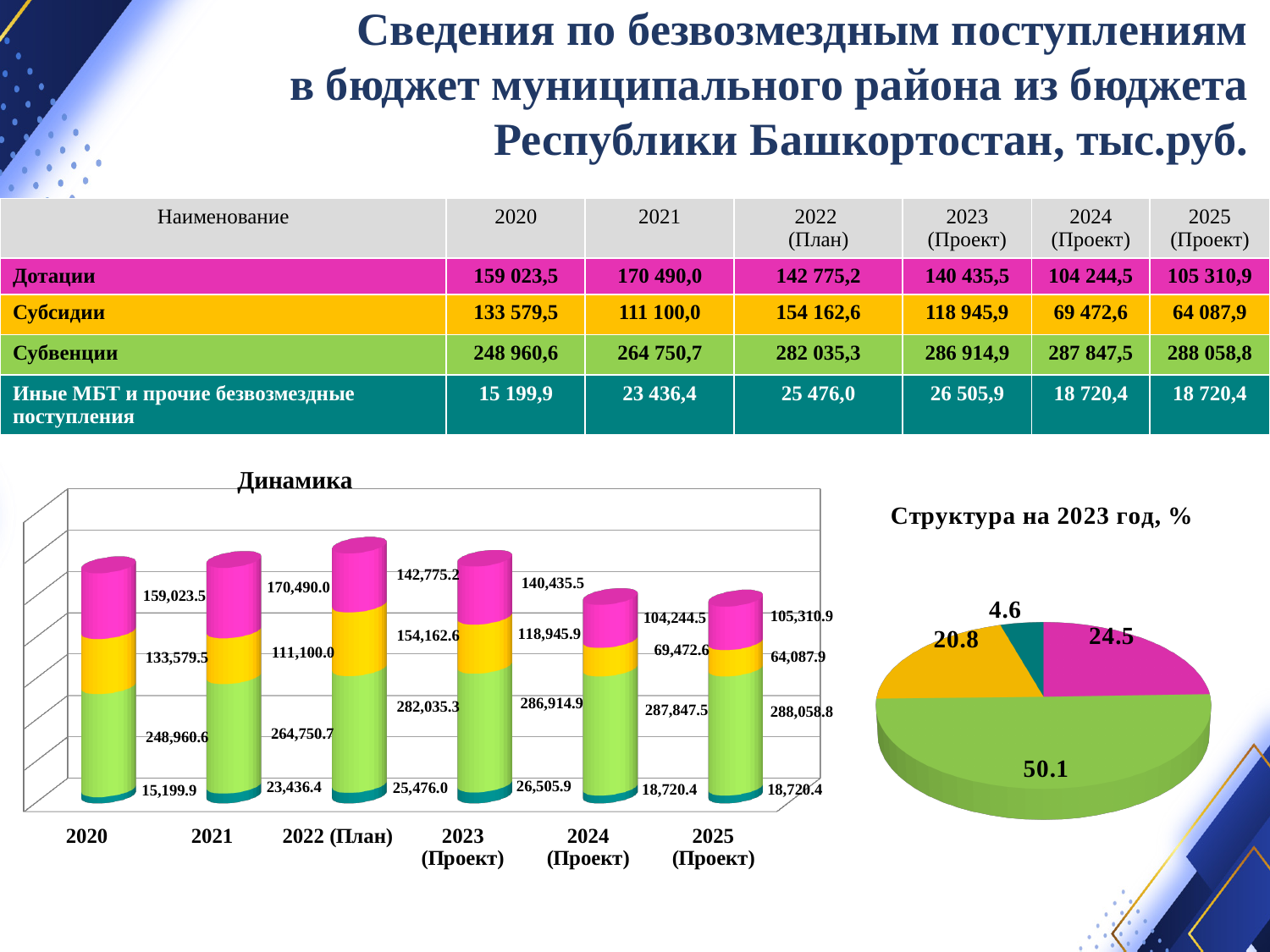
In the pie chart "Структура на 2023 год, %", what is the share of the largest slice? 50.1 In the "Динамика" chart, what is the value of the pink (top) segment for 2024 (Проект)? 104,244.5 In the "Динамика" chart, which year has the lowest yellow segment? 2025 (Проект) How many years (categories) are shown on the x axis of the "Динамика" chart? 6 In the "Динамика" chart, what is the value of the green segment for 2021? 264,750.7 In the "Динамика" chart, what is the total of the stacked bar for 2020? 556,763.5 In the "Динамика" chart, what is the difference between the pink segment values for 2021 and 2020? 11,466.5 In the "Динамика" chart, does the green segment rise or fall from 2020 to 2025 (Проект)? Rises In the "Динамика" chart, which year has the highest pink (top) segment? 2021 In the "Динамика" chart, is the teal (bottom) segment larger for 2023 (Проект) or for 2024 (Проект)? 2023 (Проект) What kind of chart is the "Динамика" chart? Stacked bar chart In the pie chart "Структура на 2023 год, %", what is the share of the smallest slice? 4.6